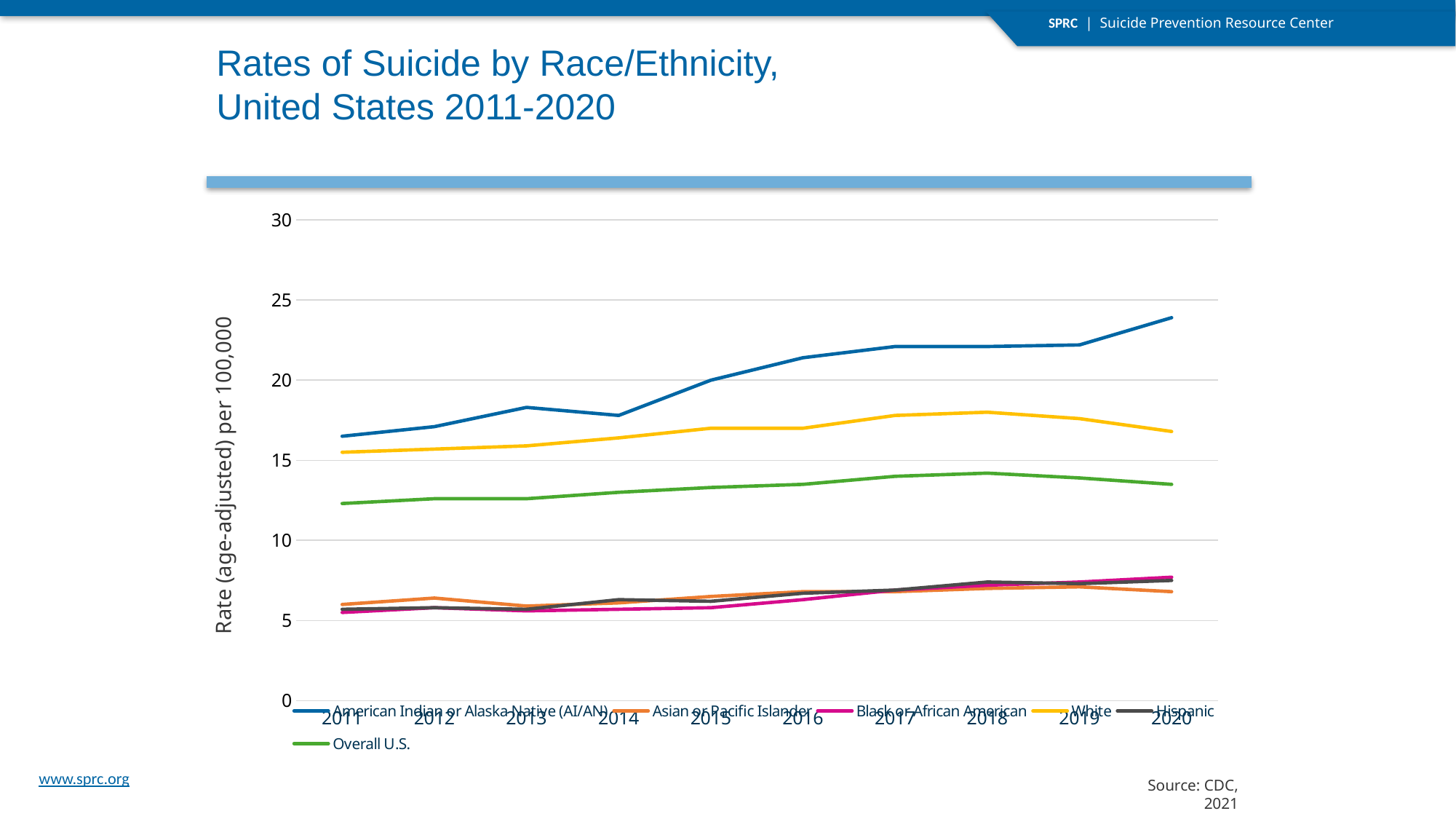
Is the value for Hispanic in 2011 greater or less than 10? less What is the label on the y axis? Rate (age-adjusted) per 100,000 Is the value for Overall U.S. in 2011 greater or less than 10? greater Is the value for White in 2018 greater or less than 20? less Which is larger in 2015, the rate for American Indian or Alaska Native (AI/AN) or the rate for White? American Indian or Alaska Native (AI/AN) What kind of chart is shown on the slide? Line chart How many series does the legend list? 6 How many years are plotted along the x axis? 10 Which group has the highest suicide rate in 2020? American Indian or Alaska Native (AI/AN) Does the rate for American Indian or Alaska Native (AI/AN) rise or fall from 2011 to 2020? Rise Which group has the lowest suicide rate in 2020? Asian or Pacific Islander